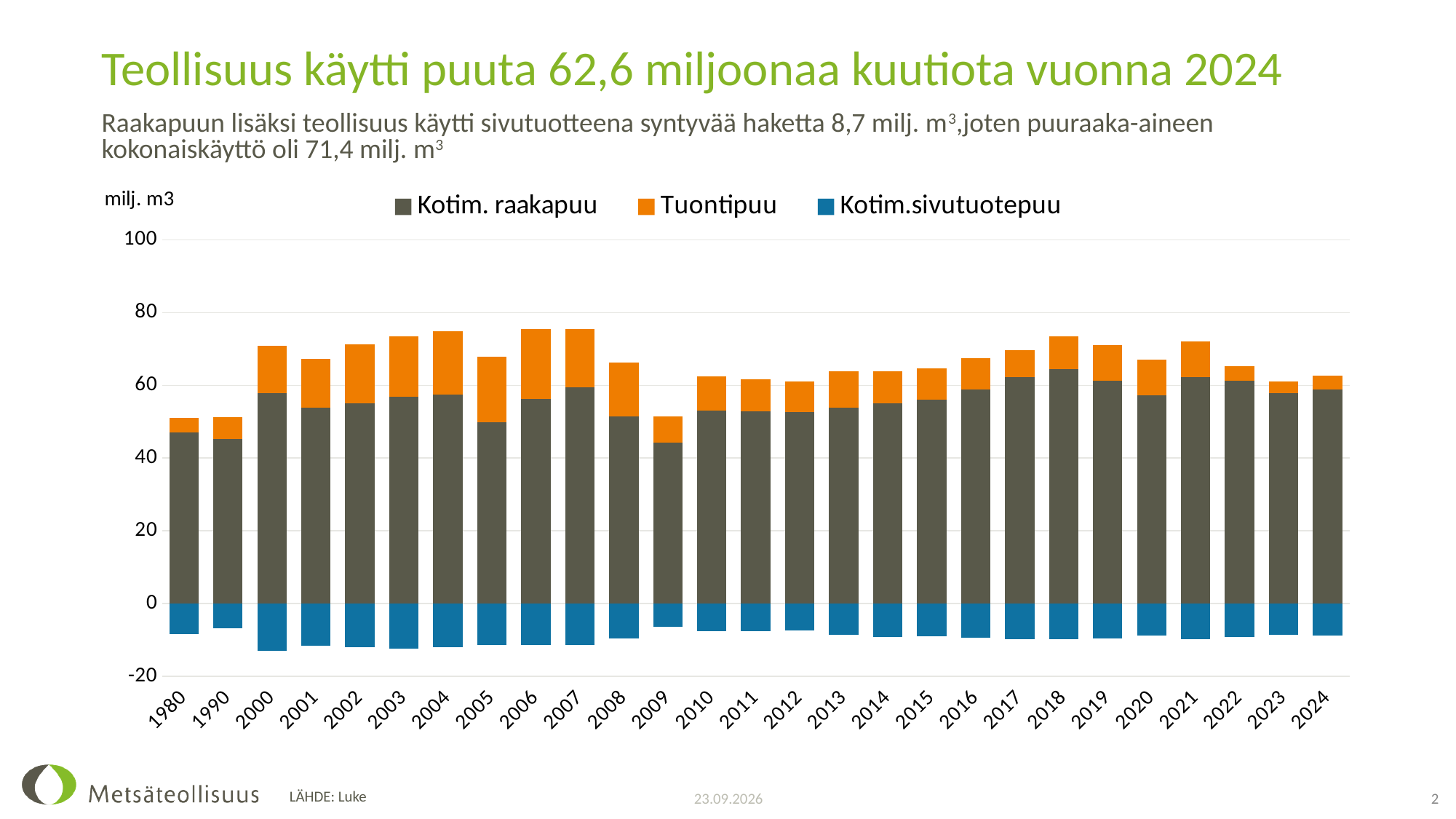
Which series is shown in orange? Tuontipuu Is the Kotim. raakapuu value for 2009 greater or less than 60? less What kind of chart is shown on the slide? Stacked bar chart Which is larger, the Tuontipuu value for 2007 or for 2022? 2007 Is the Kotim. raakapuu value for 2017 greater or less than 60? greater Is the Kotim. raakapuu value for 1980 greater or less than 60? less Which is larger, the Kotim. raakapuu value for 2000 or for 2009? 2000 Which year has the lowest Kotim. raakapuu value? 2009 How many years are shown on the x axis? 27 How many series does the legend list? 3 What unit is given for the y axis? milj. m3